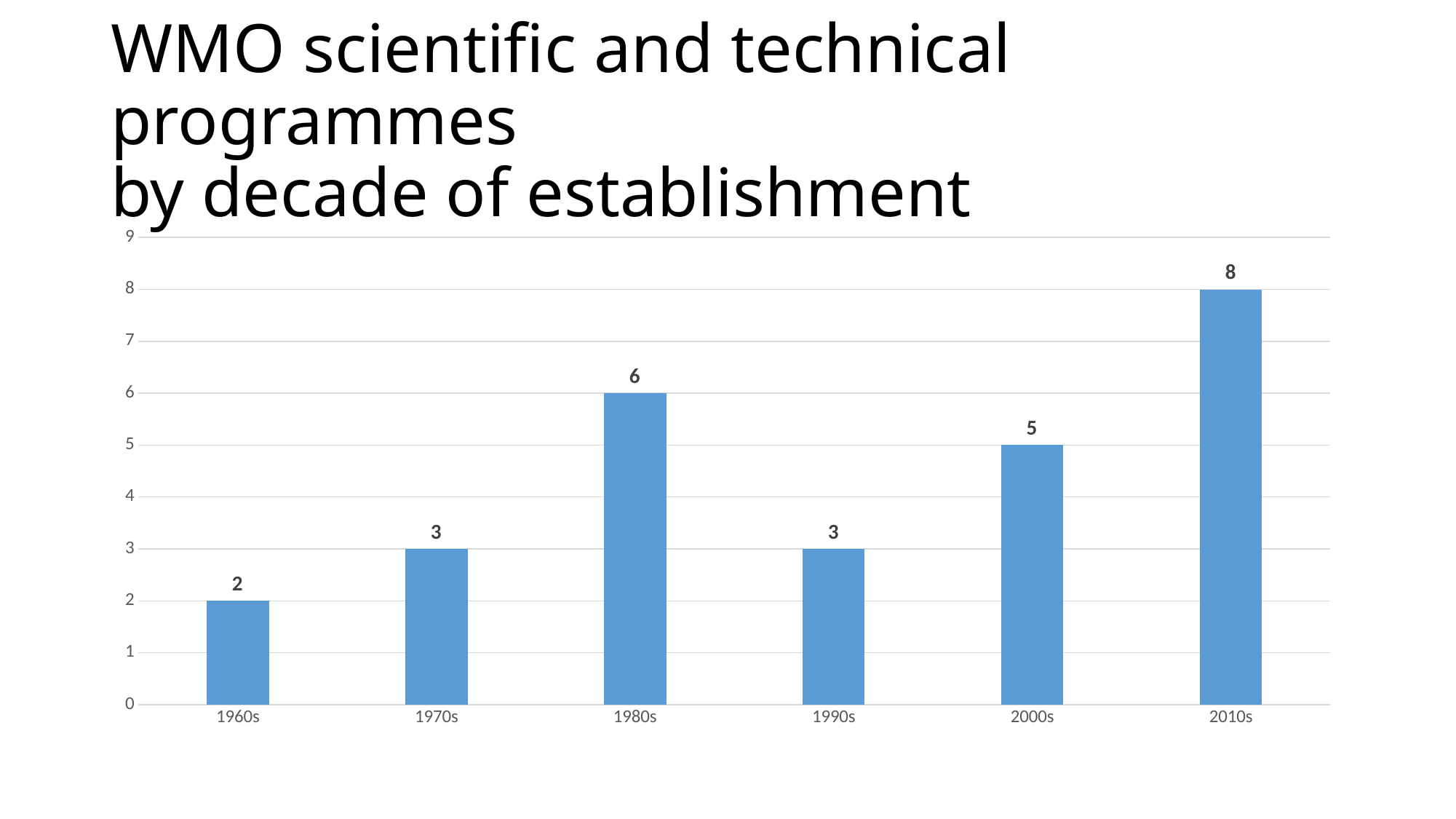
What is the value shown for the 1960s? 2 What is the value shown for the 2010s? 8 What is the title of the chart on the slide? WMO scientific and technical programmes by decade of establishment What is the difference between the values for the 2010s and the 1990s? 5 Which decade has the highest number of programmes established? 2010s What kind of chart is shown on the slide? Bar chart Which decade has the lowest number of programmes established? 1960s Which is larger, the value for the 1980s or the value for the 2000s? 1980s How many WMO scientific and technical programmes were established in the 1980s? 6 How many decades are shown on the x axis? 6 Is the value for the 2000s greater or less than 4? greater Do the values rise or fall from the 1990s to the 2010s? Rise